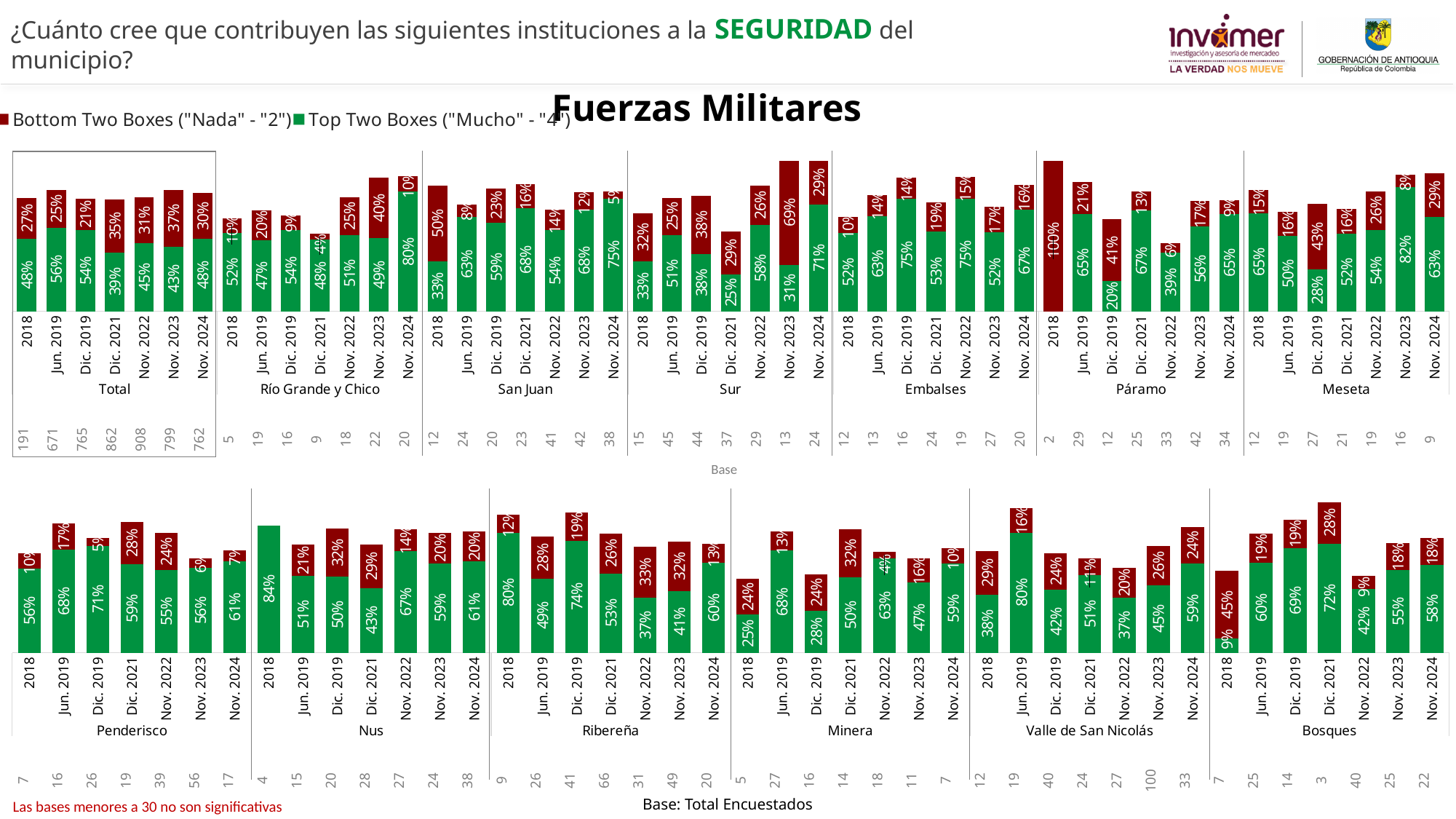
In the top chart, what is the Top Two Boxes value for Total in Nov. 2024? 48% In the top chart, what is the total of the stacked bar for Río Grande y Chico in Nov. 2023? 89% In the top chart, which year has the lowest Top Two Boxes value for Total? Dic. 2021 What type of chart is shown on the slide? Stacked bar chart In the top chart, what is the Bottom Two Boxes value for Páramo in 2018? 100% In the bottom chart, what is the Top Two Boxes value for Nus in 2018? 84% How many series does the legend list? 2 In the bottom chart, which year has the lowest Top Two Boxes value for Bosques? 2018 In the bottom chart, which is larger: the Top Two Boxes value for Minera in Jun. 2019 or in Dic. 2019? Jun. 2019 In the top chart, what is the Bottom Two Boxes value for Sur in Nov. 2023? 69% In the top chart, which year has the highest Top Two Boxes value for Meseta? Nov. 2023 In the top chart, what is the difference between the Top Two Boxes values for San Juan in Nov. 2024 and 2018? 42%